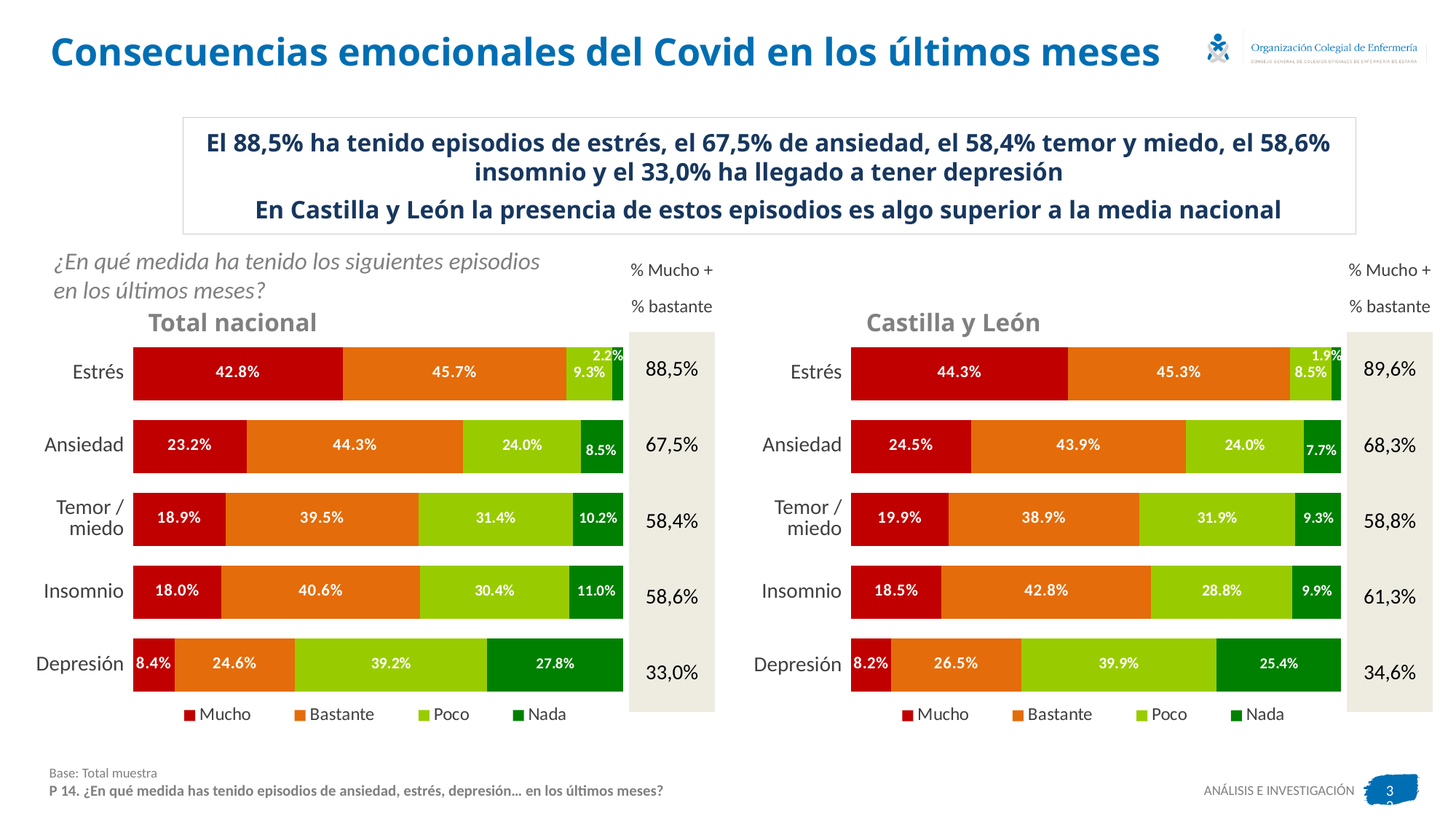
In the Total nacional chart, what is the Mucho value for Estrés? 42.8% How many categories are shown in the Total nacional chart? 5 In the Total nacional chart, which category has the highest Mucho value? Estrés In the Castilla y León chart, what colour represents the Nada series? Dark green In the Castilla y León chart, what is the Poco value for Temor / miedo? 31.9% How many series does the legend of the Castilla y León chart list? 4 In the Castilla y León chart, what is the Bastante value for Insomnio? 42.8% In the Castilla y León chart, which category has the lowest Mucho value? Depresión What kind of chart is the Total nacional chart? Stacked bar chart In the Castilla y León chart, which is larger: the Poco value for Ansiedad or the Poco value for Insomnio? Insomnio In the Total nacional chart, what is the Nada value for Depresión? 27.8% In the Total nacional chart, what is the difference between the Bastante values for Ansiedad and Depresión? 19.7%